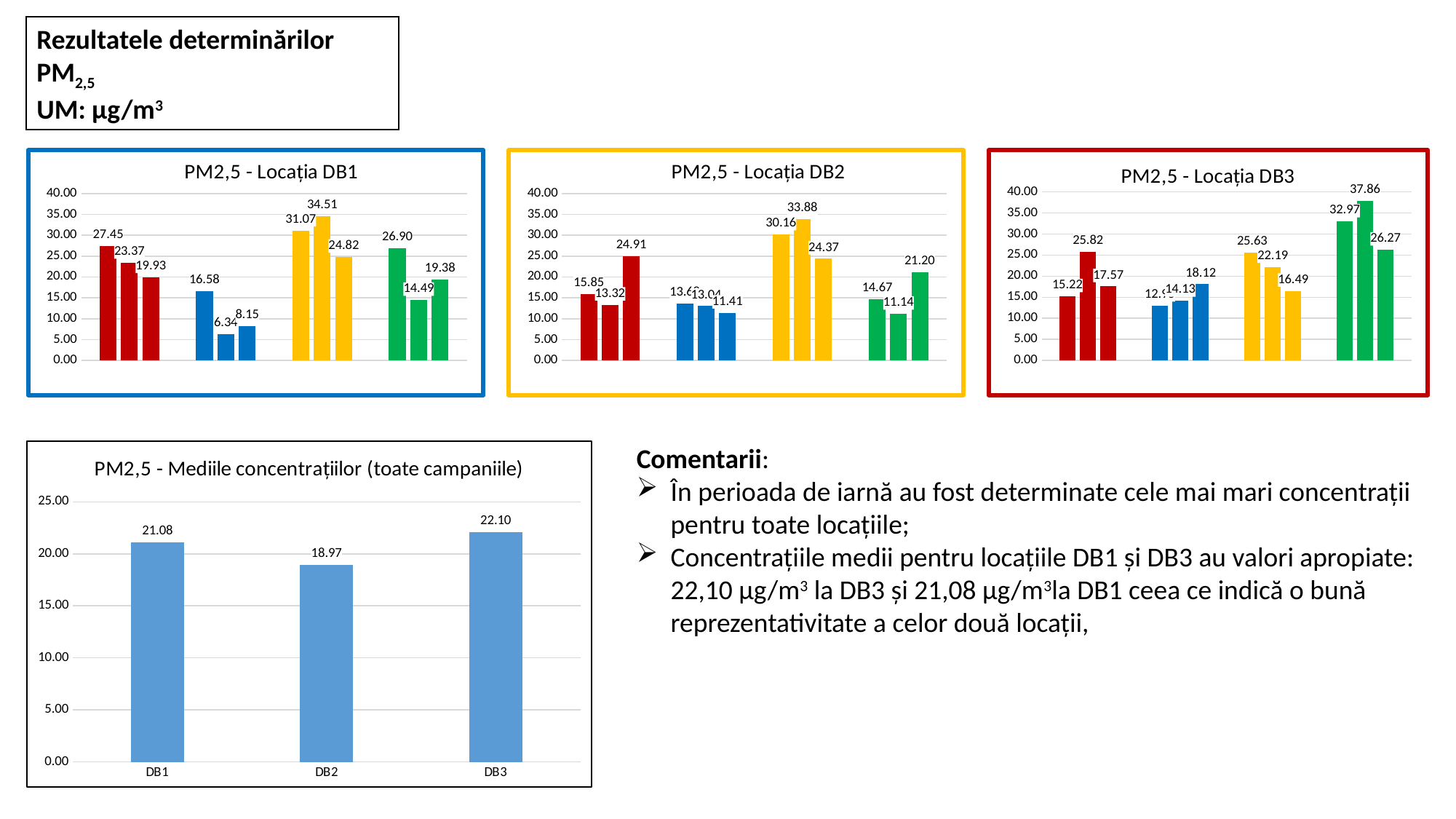
In the chart 'PM2,5 - Locația DB2', what is the lowest value shown? 11.14 In the chart 'PM2,5 - Mediile concentrațiilor (toate campaniile)', is the value for DB2 greater or less than 20.00? less In the chart 'PM2,5 - Locația DB1', what is the highest value shown? 34.51 In the chart 'PM2,5 - Mediile concentrațiilor (toate campaniile)', what is the value for DB1? 21.08 In the chart 'PM2,5 - Mediile concentrațiilor (toate campaniile)', which location has the highest value? DB3 In the chart 'PM2,5 - Mediile concentrațiilor (toate campaniile)', which location has the lowest value? DB2 In the chart 'PM2,5 - Locația DB3', what is the highest value shown? 37.86 In the chart 'PM2,5 - Mediile concentrațiilor (toate campaniile)', what is the value for DB2? 18.97 How many locations are shown in the chart 'PM2,5 - Mediile concentrațiilor (toate campaniile)'? 3 What kind of chart is 'PM2,5 - Locația DB1'? bar chart In the chart 'PM2,5 - Mediile concentrațiilor (toate campaniile)', which is larger, the value for DB1 or the value for DB2? DB1 In the chart 'PM2,5 - Mediile concentrațiilor (toate campaniile)', what is the difference between the values for DB3 and DB1? 1.02